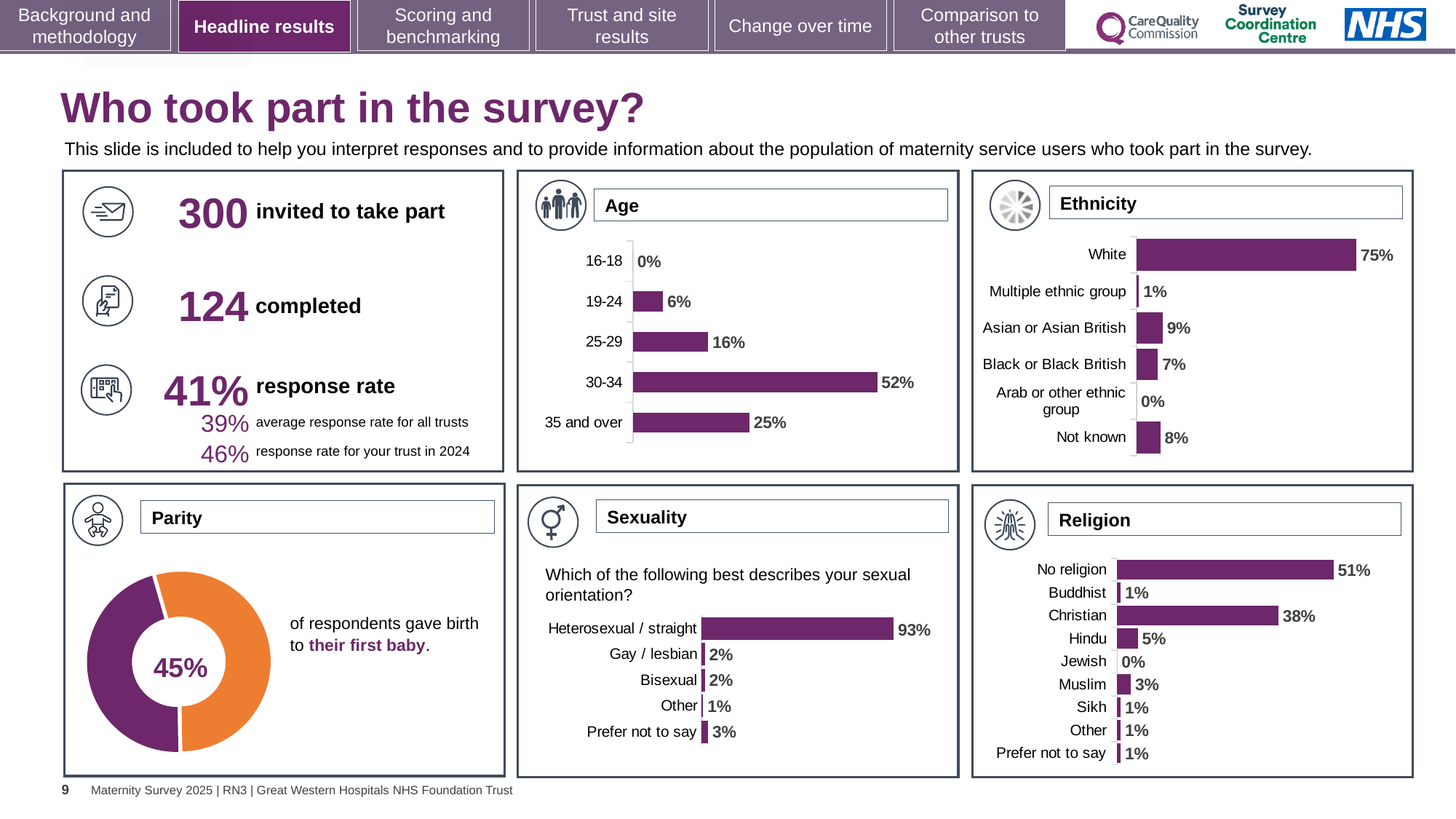
What kind of chart is used in the Parity panel? Donut (pie) chart In the Age chart, what percentage of respondents were aged 30-34? 52% In the Ethnicity chart, what percentage of respondents were White? 75% In the Ethnicity chart, which is larger: Asian or Asian British, or Black or Black British? Asian or Asian British In the Ethnicity chart, what percentage is shown for Not known? 8% In the Sexuality chart, what percentage of respondents answered Heterosexual / straight? 93% In the Age chart, which age group has the highest percentage? 30-34 In the Parity chart, what percentage of respondents gave birth to their first baby? 45% In the Age chart, what is the difference between the 35 and over group and the 25-29 group? 9% In the Religion chart, what is the difference between No religion and Christian? 13% How many age groups are shown in the Age chart? 5 In the Religion chart, which category has the highest percentage? No religion